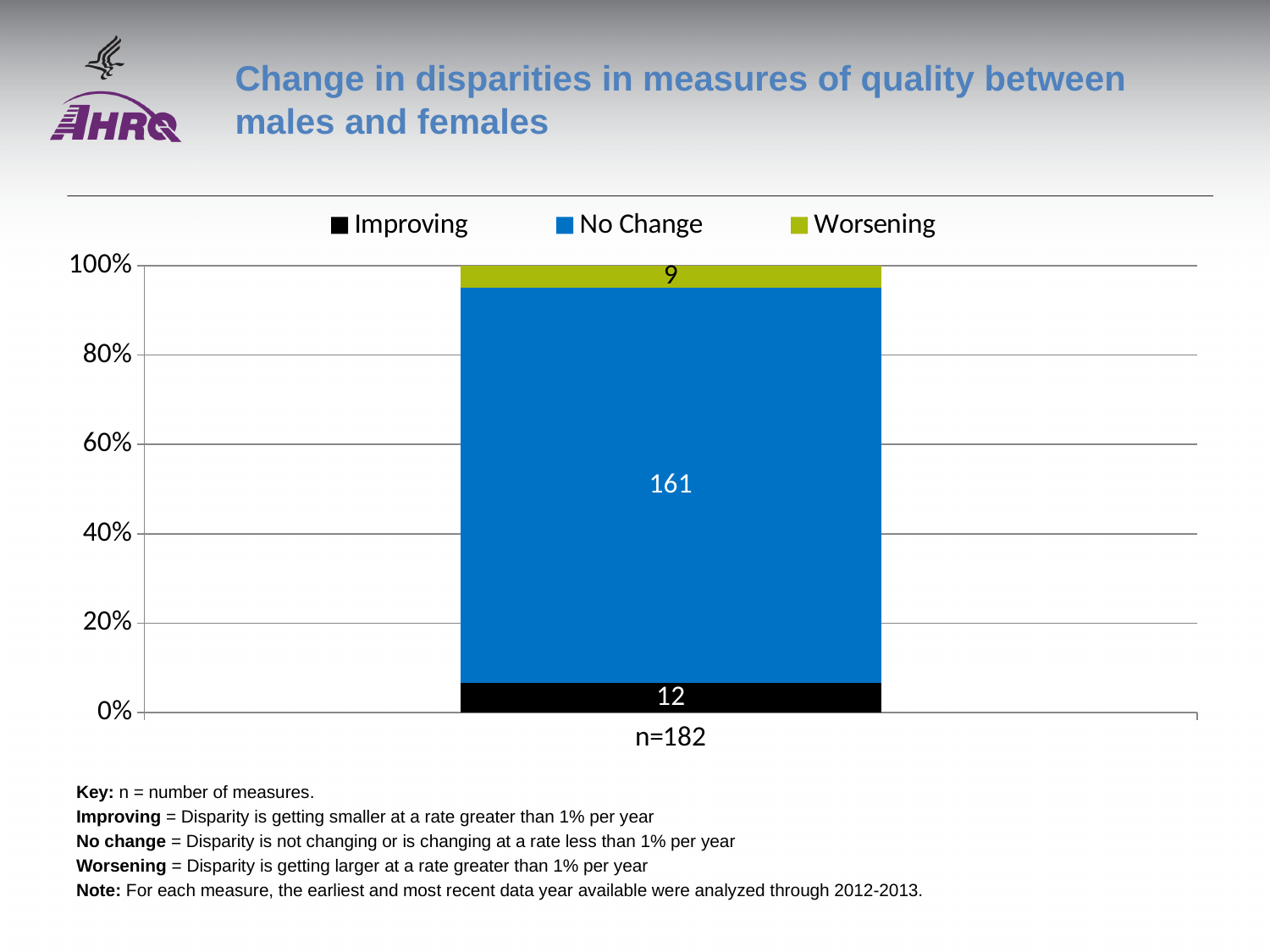
What is the difference between the Improving value and the Worsening value? 3 How many series does the legend list? 3 What kind of chart is shown on the slide? Stacked bar chart What is the value for the Improving segment of the stacked bar? 12 Which series has the smallest value in the stacked bar? Worsening What is the total of the three segments in the stacked bar? 182 What is the value for the No Change segment of the stacked bar? 161 Which series has the largest value in the stacked bar? No Change What is the difference between the No Change value and the Improving value? 149 What is the label shown beneath the bar on the x axis? n=182 Which is larger, the Improving value or the Worsening value? Improving What is the value for the Worsening segment of the stacked bar? 9